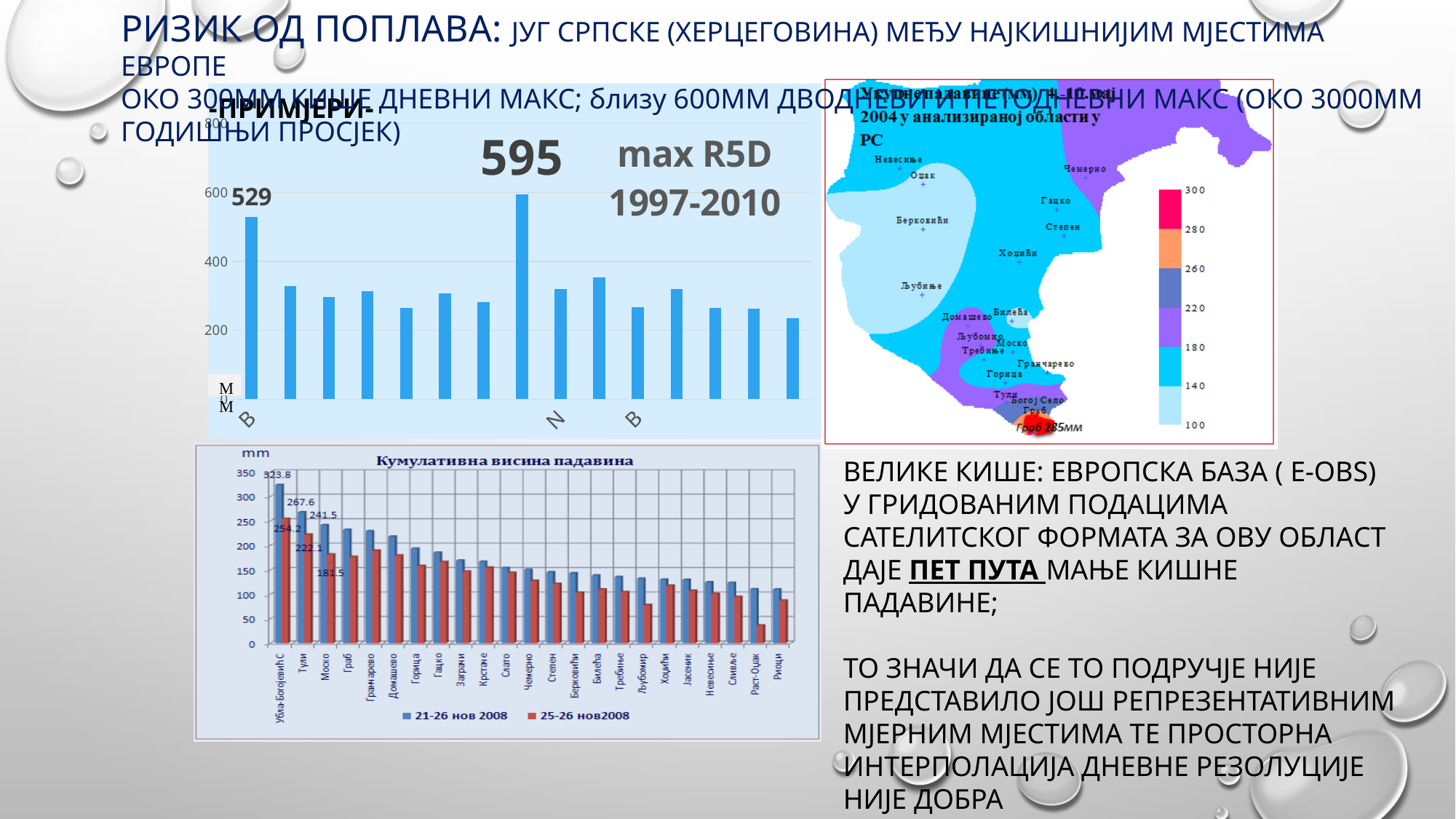
In the bottom-left chart 'Кумулативна висина падавина', what is the value for Тули in the 25-26 нов2008 series? 222.1 In the bottom-left chart 'Кумулативна висина падавина', what is the value for Убла-Богојевић С in the 21-26 нов 2008 series? 323.8 In the top-left chart (max R5D 1997-2010), what is the value of the first bar on the left? 529 In the top-left chart (max R5D 1997-2010), is the value of the first bar greater or less than 400? greater In the top-left chart (max R5D 1997-2010), what is the difference between the two labelled values 595 and 529? 66 In the bottom-left chart 'Кумулативна висина падавина', which category has the highest value in the 21-26 нов 2008 series? Убла-Богојевић С In the bottom-left chart 'Кумулативна висина падавина', what is the difference between the 21-26 нов 2008 and 25-26 нов2008 values for Моско? 60 How many series does the legend of the bottom-left chart 'Кумулативна висина падавина' list? 2 In the bottom-left chart 'Кумулативна висина падавина', do the 21-26 нов 2008 values generally rise or fall from left to right? fall In the top-left chart (max R5D 1997-2010), what is the highest value shown? 595 What kind of chart is the top-left chart (max R5D 1997-2010)? bar chart In the bottom-left chart 'Кумулативна висина падавина', is the 25-26 нов2008 value for Раст-Оџак greater or less than 50? less